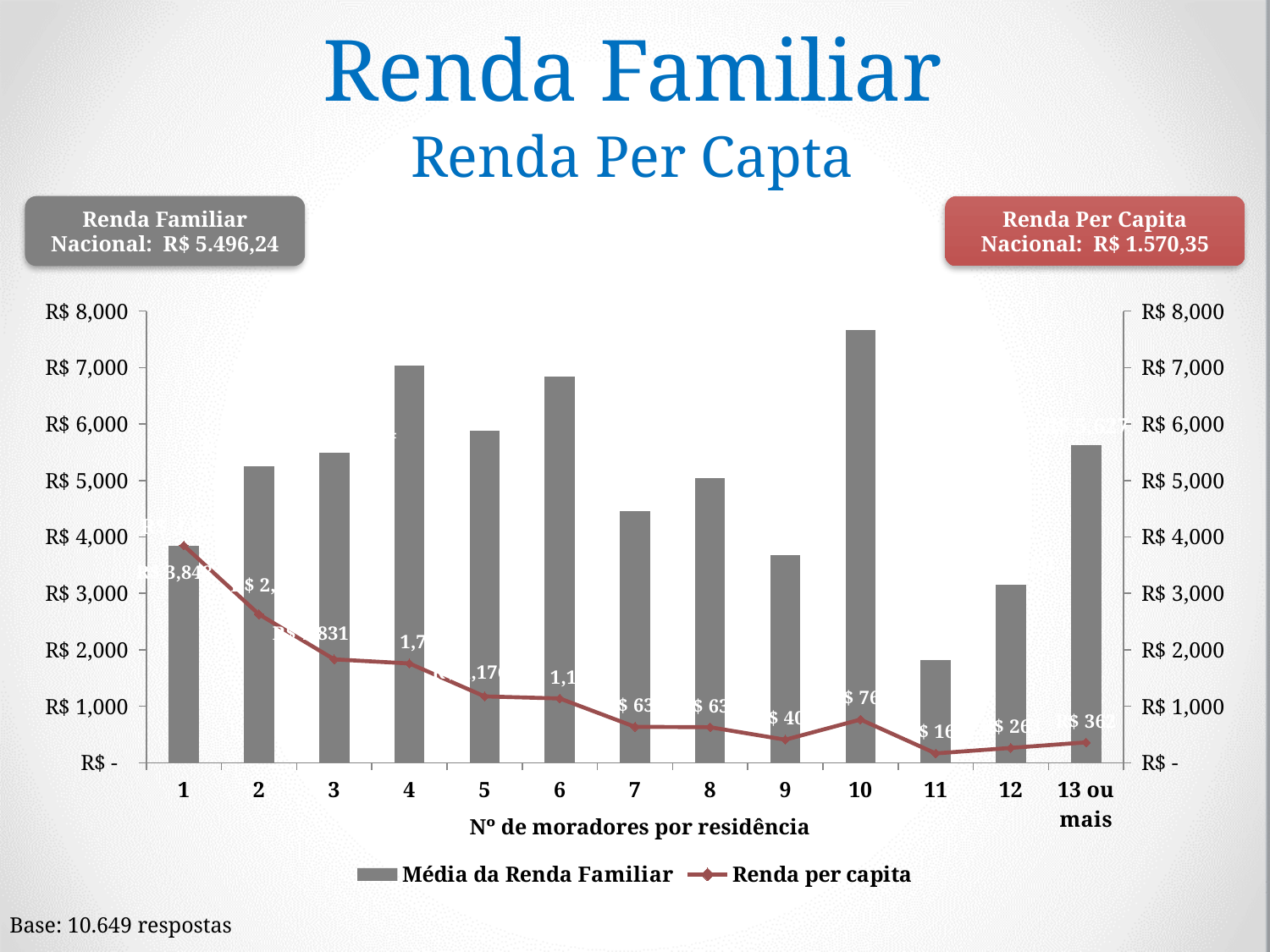
Which is larger, the 'Média da Renda Familiar' bar for 4 residents or for 7 residents? 4 residents What kind of chart is shown on the slide? A combined bar and line chart Is the 'Média da Renda Familiar' bar for 11 residents greater or less than R$ 2,000? less Which category has the highest 'Renda per capita' value? 1 How many series does the legend list? 2 Is the 'Média da Renda Familiar' bar for 10 residents greater or less than R$ 7,000? greater Is the 'Média da Renda Familiar' bar for 9 residents greater or less than R$ 4,000? less Which number of residents has the lowest 'Média da Renda Familiar' bar? 11 What is the 'Renda Per Capita Nacional' value shown in the red box on the slide? R$ 1.570,35 Does the 'Renda per capita' line generally rise or fall from 1 resident to 11 residents? Fall How many categories of 'Nº de moradores por residência' are shown on the x axis? 13 Which number of residents has the highest 'Média da Renda Familiar' bar? 10